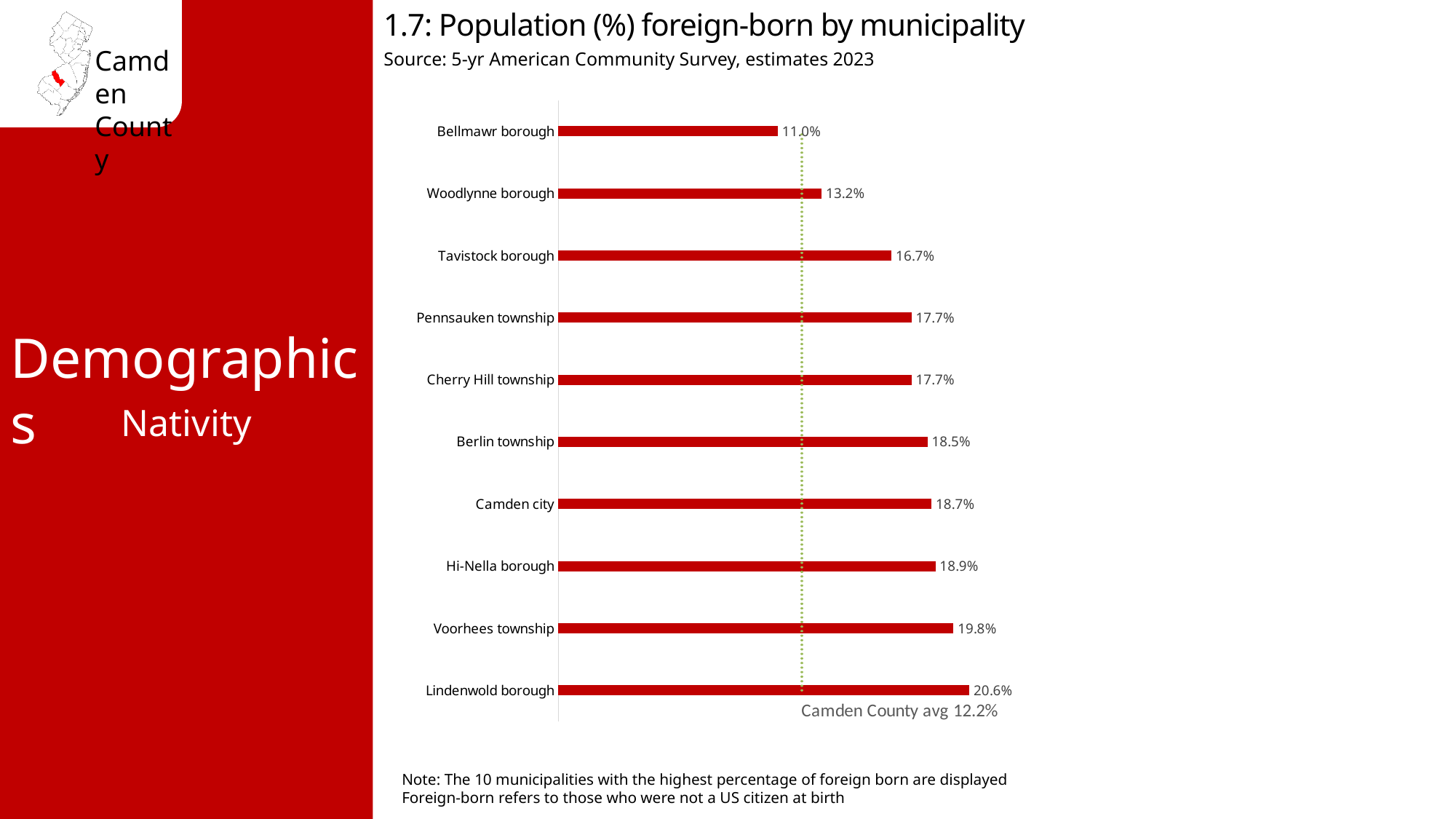
What is the Camden County average foreign-born percentage shown by the dotted line? 12.2% How many municipalities are shown on the chart? 10 What is the foreign-born population percentage for Camden city? 18.7% Which municipality has the highest percentage of foreign-born population? Lindenwold borough What is the difference between the foreign-born percentages of Lindenwold borough and Bellmawr borough? 9.6% What is the foreign-born population percentage for Lindenwold borough? 20.6% What is the difference between the foreign-born percentages of Berlin township and Tavistock borough? 1.8% What is the foreign-born population percentage for Bellmawr borough? 11.0% Which municipality has the lowest percentage of foreign-born population on the chart? Bellmawr borough What kind of chart is used to show the foreign-born population by municipality? Bar chart What is the foreign-born population percentage for Woodlynne borough? 13.2% Which has a higher foreign-born percentage, Voorhees township or Hi-Nella borough? Voorhees township